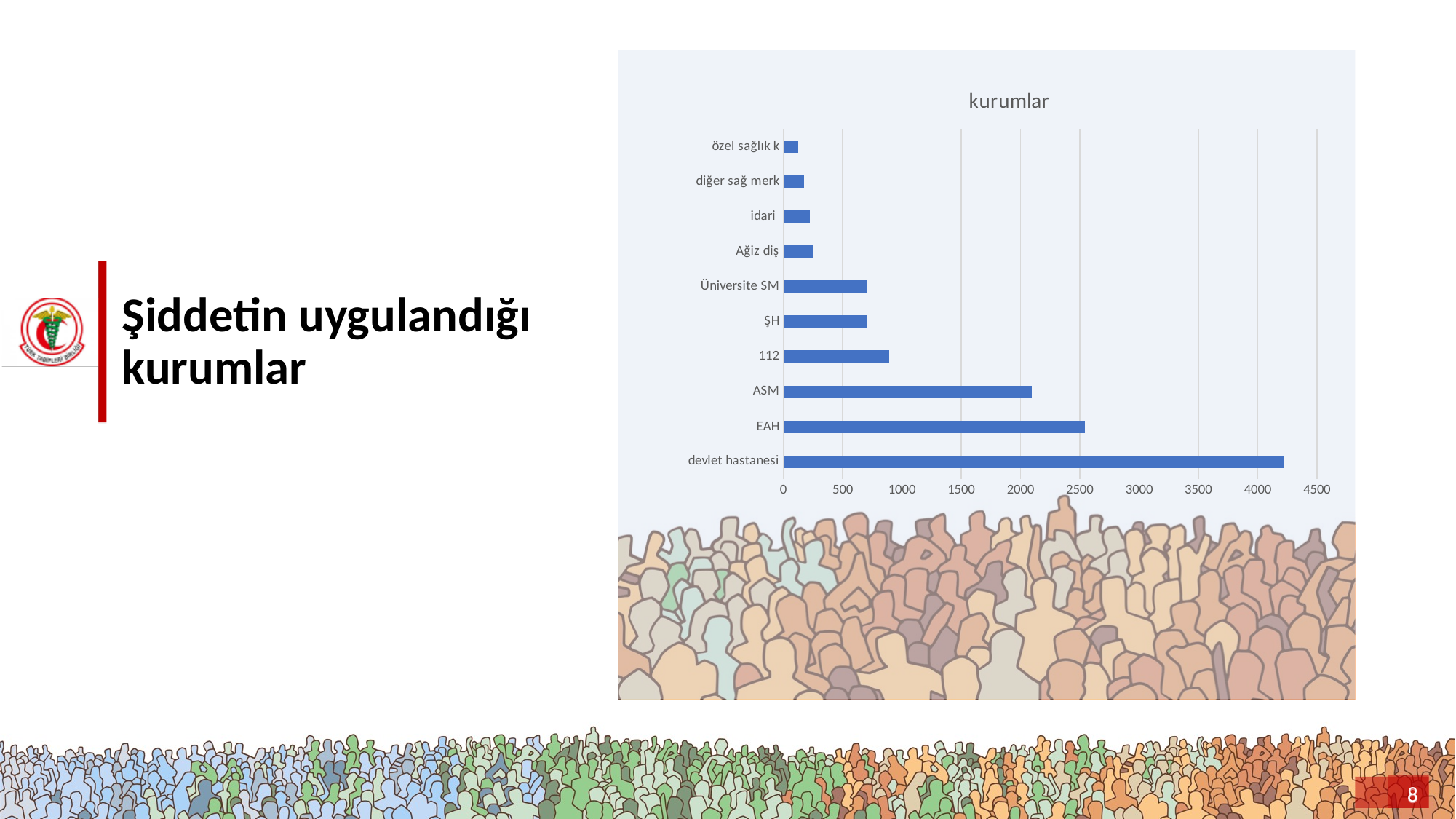
Which has a larger value, EAH or ASM? EAH What is the title of the chart? kurumlar Is the value for devlet hastanesi greater or less than 4000? greater Is the value for ASM greater or less than 2500? less What kind of chart is shown on the slide? bar chart What is the maximum value shown on the horizontal axis? 4500 How many categories are shown in the chart? 10 Is the value for Ağiz diş greater or less than 500? less Which has a larger value, 112 or ŞH? 112 Which category has the highest value? devlet hastanesi